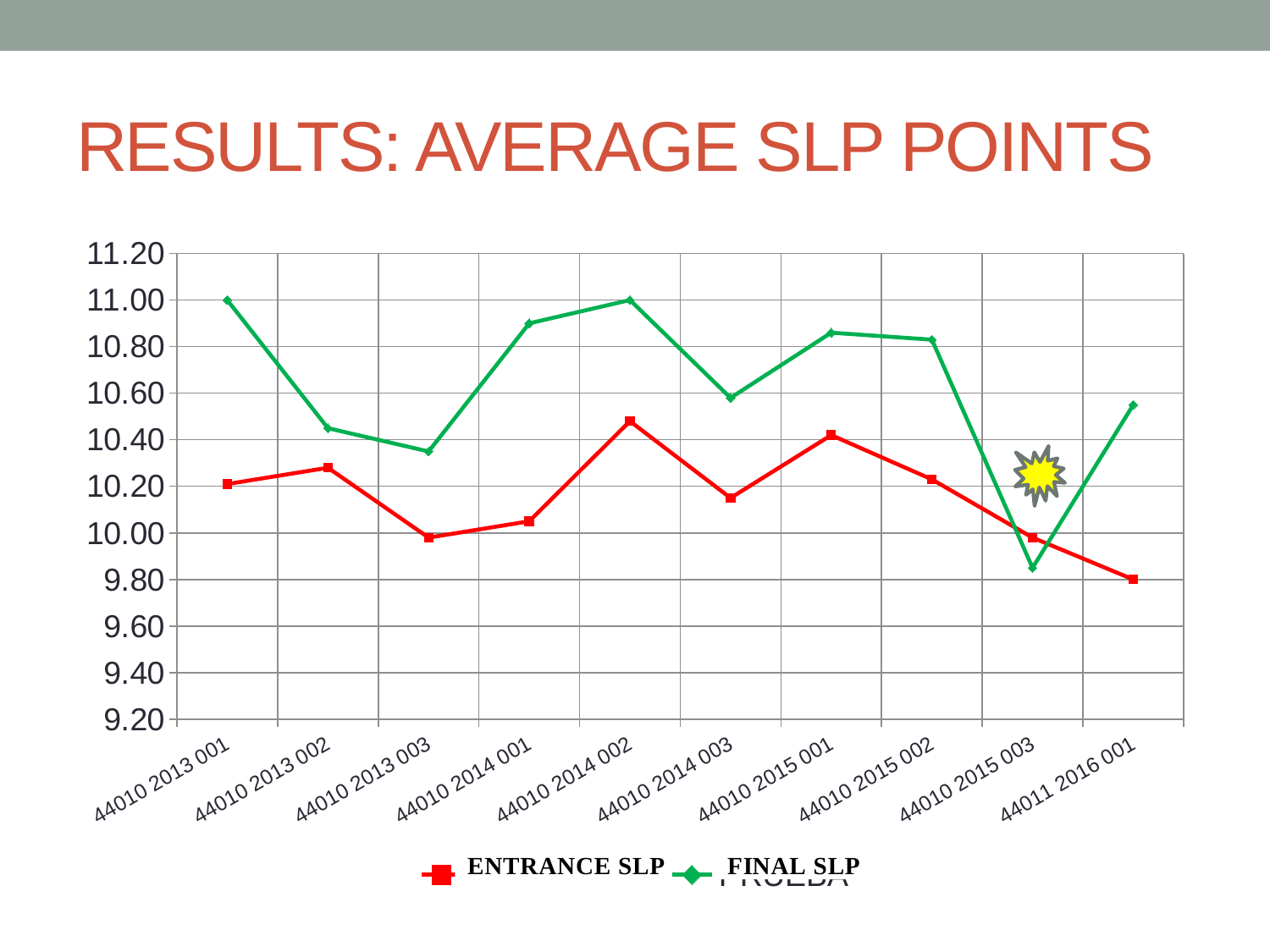
Is the ENTRANCE SLP value for 44010 2014 002 greater or less than 10.20? greater Does the ENTRANCE SLP line rise or fall from 44010 2015 001 to 44011 2016 001? Fall How many series does the legend list? 2 How many categories are plotted along the x axis? 10 Is the ENTRANCE SLP value for 44011 2016 001 greater or less than 10.00? less Is the FINAL SLP value for 44010 2013 001 greater or less than 10.80? greater Which category has the lowest ENTRANCE SLP value? 44011 2016 001 What kind of chart is shown on the slide? Line chart For 44010 2013 001, which series has the larger value, ENTRANCE SLP or FINAL SLP? FINAL SLP Which category has the lowest FINAL SLP value? 44010 2015 003 What colour is the FINAL SLP line? Green